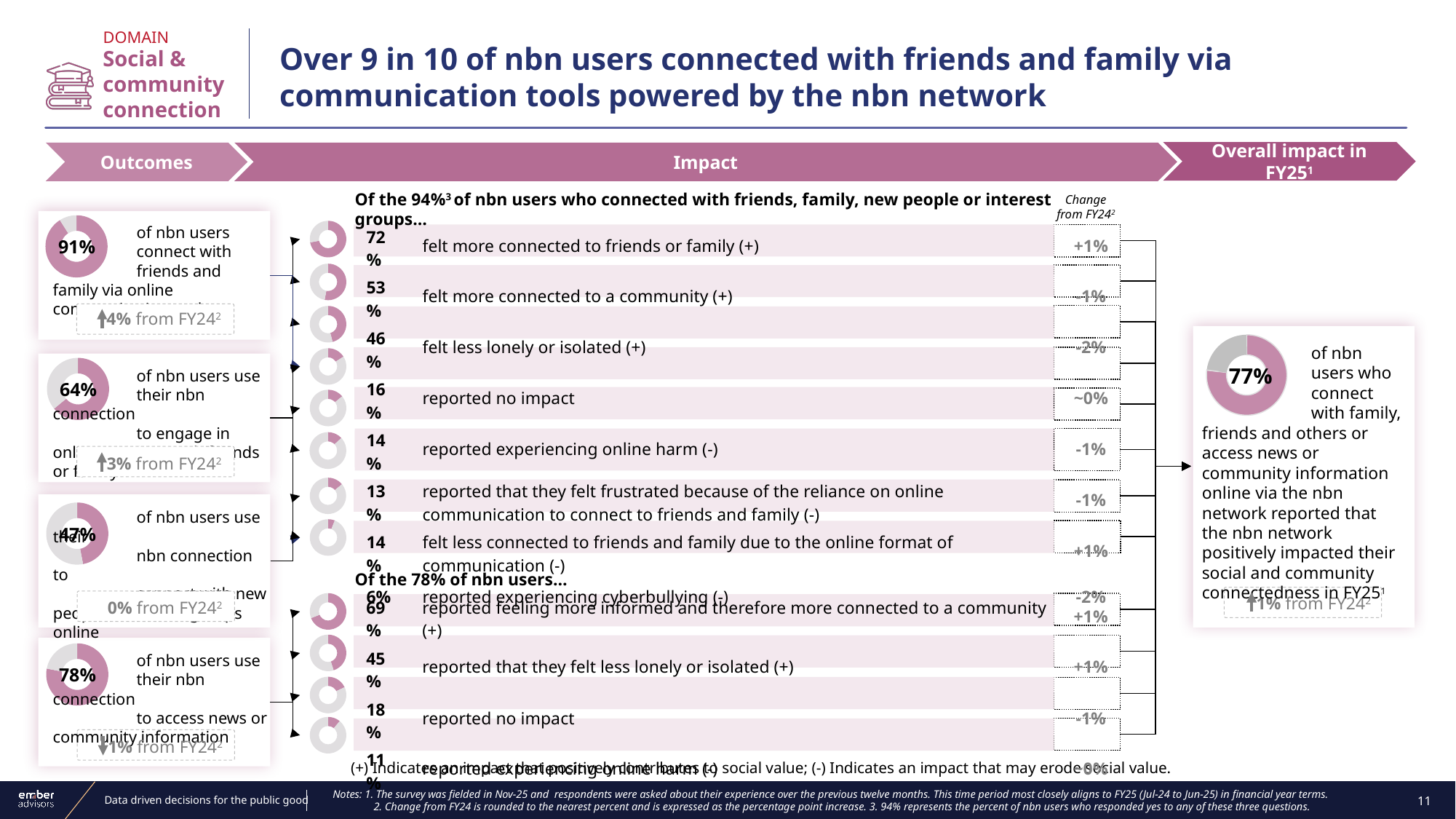
Of the 78% of nbn users, which is larger: the share who reported feeling more informed (69%) or the share who reported feeling less lonely or isolated (45%)? 69% reported feeling more informed In the Outcomes column, what percentage of nbn users use their nbn connection to access news or community information? 78% What percentage of nbn users connect with friends and family via online communication tools, as shown in the top Outcomes donut chart? 91% Among the four Outcomes donut charts, which outcome has the lowest percentage? 47% of nbn users use their nbn connection to connect with new people In the Impact section, what percentage of the 94% of nbn users felt more connected to friends or family? 72% How many donut charts are shown in the Outcomes column on the left of the slide? 4 In the Impact section, what percentage of the 94% of nbn users reported experiencing online harm? 14% Among the four Outcomes donut charts, which outcome has the highest percentage? 91% of nbn users connect with friends and family via online communication tools What is the change from FY24 shown for the 91% outcome of nbn users connecting with friends and family via online communication tools? +4% from FY24 What type of chart is used to show the 77% overall impact figure? Donut (pie) chart What is the difference between the share of the 94% who felt more connected to friends or family (72%) and the share who felt more connected to a community (53%)? 19 percentage points In the Overall impact in FY25 donut chart, what percentage of nbn users reported that the nbn network positively impacted their social and community connectedness? 77%